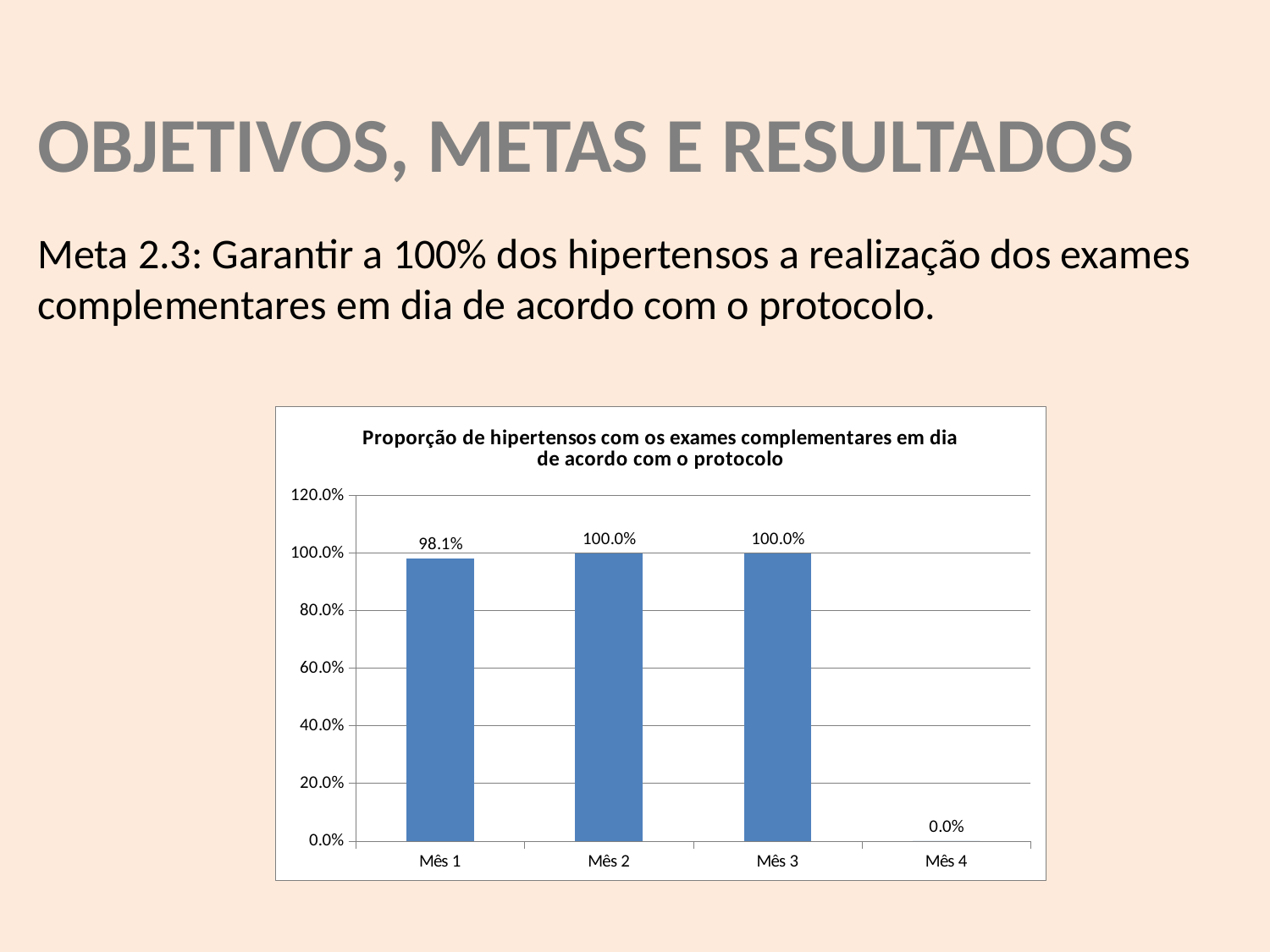
Is the value for Mês 1 greater or less than 80.0%? greater What is the highest value shown on the y axis? 120.0% How many categories are shown on the x axis? 4 What kind of chart is shown on the slide? bar chart Which category has the lowest value? Mês 4 What is the value for Mês 2? 100.0% Which is larger, the value for Mês 3 or the value for Mês 1? Mês 3 What is the title of the chart? Proporção de hipertensos com os exames complementares em dia de acordo com o protocolo What is the value for Mês 4? 0.0% What is the difference between the values for Mês 2 and Mês 1? 1.9% What is the value for Mês 1? 98.1% Do the values rise or fall from Mês 3 to Mês 4? fall